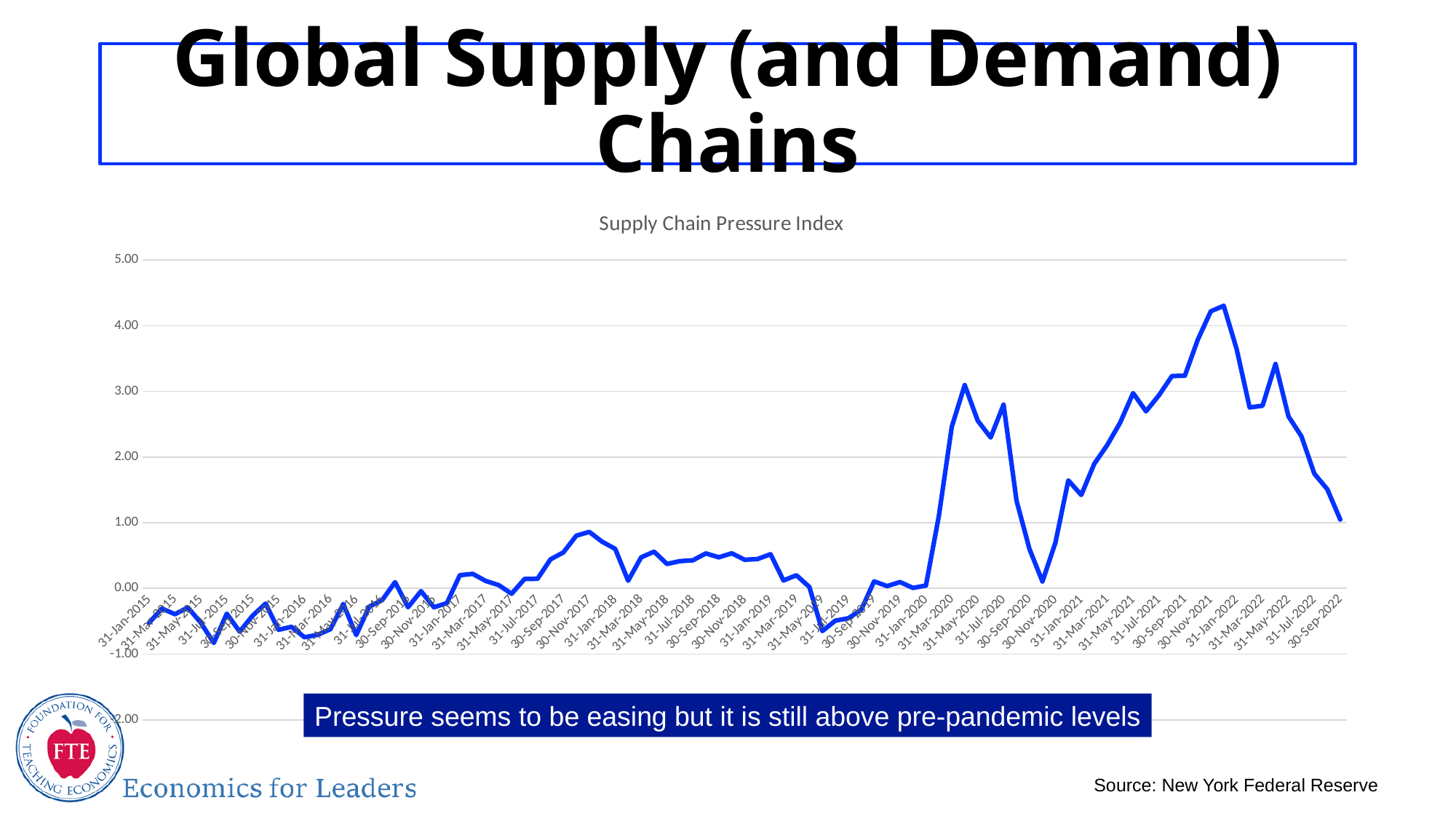
Does the line rise or fall between 31-Jan-2022 and 30-Sep-2022? fall What kind of chart is shown on the slide? line chart Is the value for 30-Sep-2020 greater or less than 1.00? less What colour is the line in the chart? blue Does the line rise or fall overall between 30-Sep-2020 and 31-Jan-2022? rise Is the value for 30-Sep-2022 greater or less than 2.00? less What is the title of the chart? Supply Chain Pressure Index Is the value for 31-Jul-2020 greater or less than 2.00? greater Which is larger, the value for 31-Jan-2022 or the value for 30-Sep-2022? 31-Jan-2022